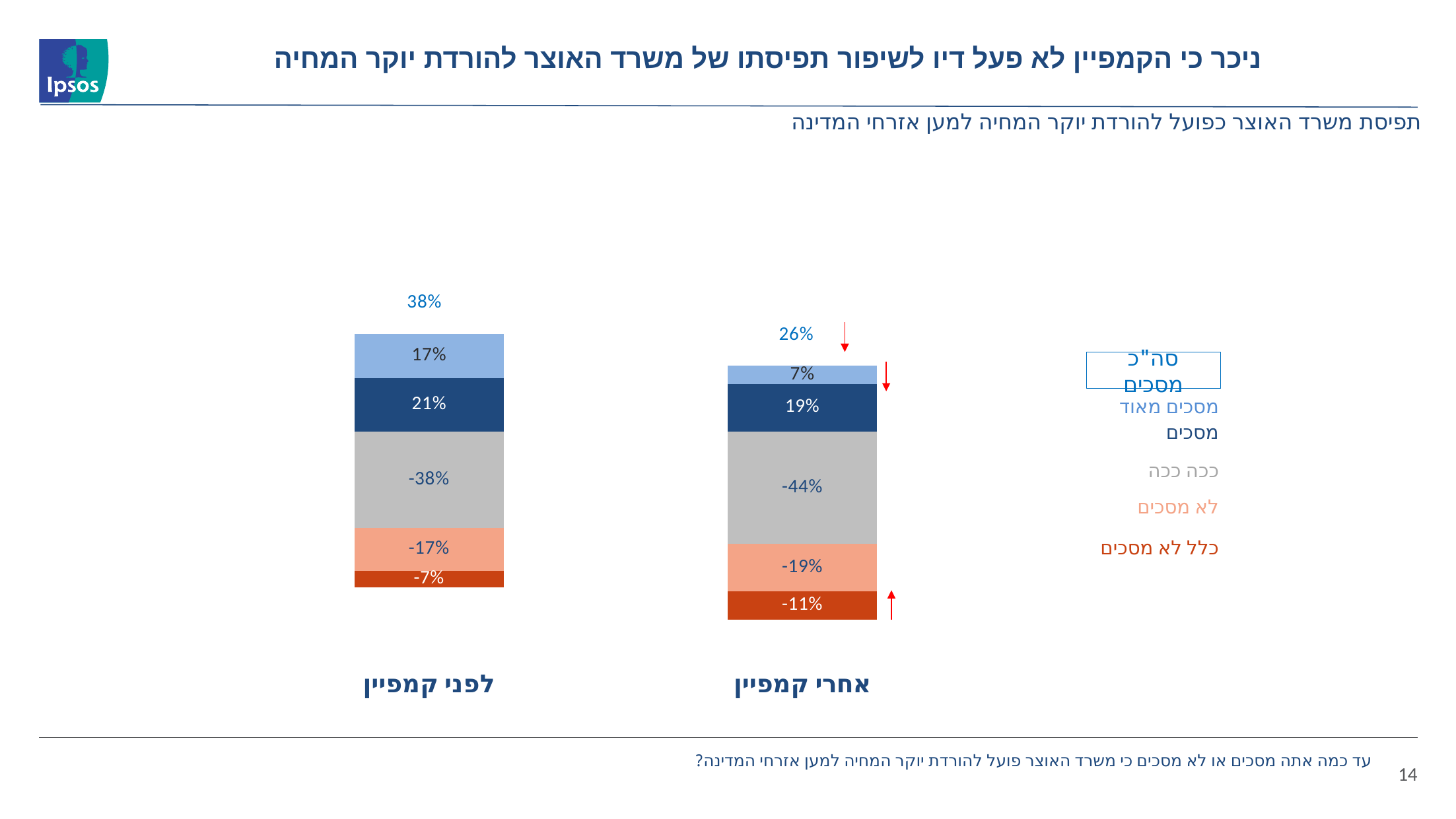
What is the total 'סה"כ מסכים' value shown above the 'לפני קמפיין' bar? 38% What is the value of the 'ככה ככה' segment for 'אחרי קמפיין'? -44% How many series does the legend list (excluding the total label)? 5 What is the value of the 'כלל לא מסכים' segment for 'לפני קמפיין'? -7% Does the 'סה"כ מסכים' total rise or fall from 'לפני קמפיין' to 'אחרי קמפיין'? fall What type of chart is shown on the slide? stacked bar chart How many bars (categories) are plotted in the chart? 2 What is the difference between the 'סה"כ מסכים' totals for 'לפני קמפיין' and 'אחרי קמפיין'? 12 percentage points What is the value of the 'מסכים מאוד' segment for 'אחרי קמפיין'? 7% Which bar has the larger 'מסכים' (dark blue) segment, 'לפני קמפיין' or 'אחרי קמפיין'? לפני קמפיין What is the total 'סה"כ מסכים' value shown above the 'אחרי קמפיין' bar? 26% What is the value of the 'מסכים מאוד' segment for 'לפני קמפיין'? 17%